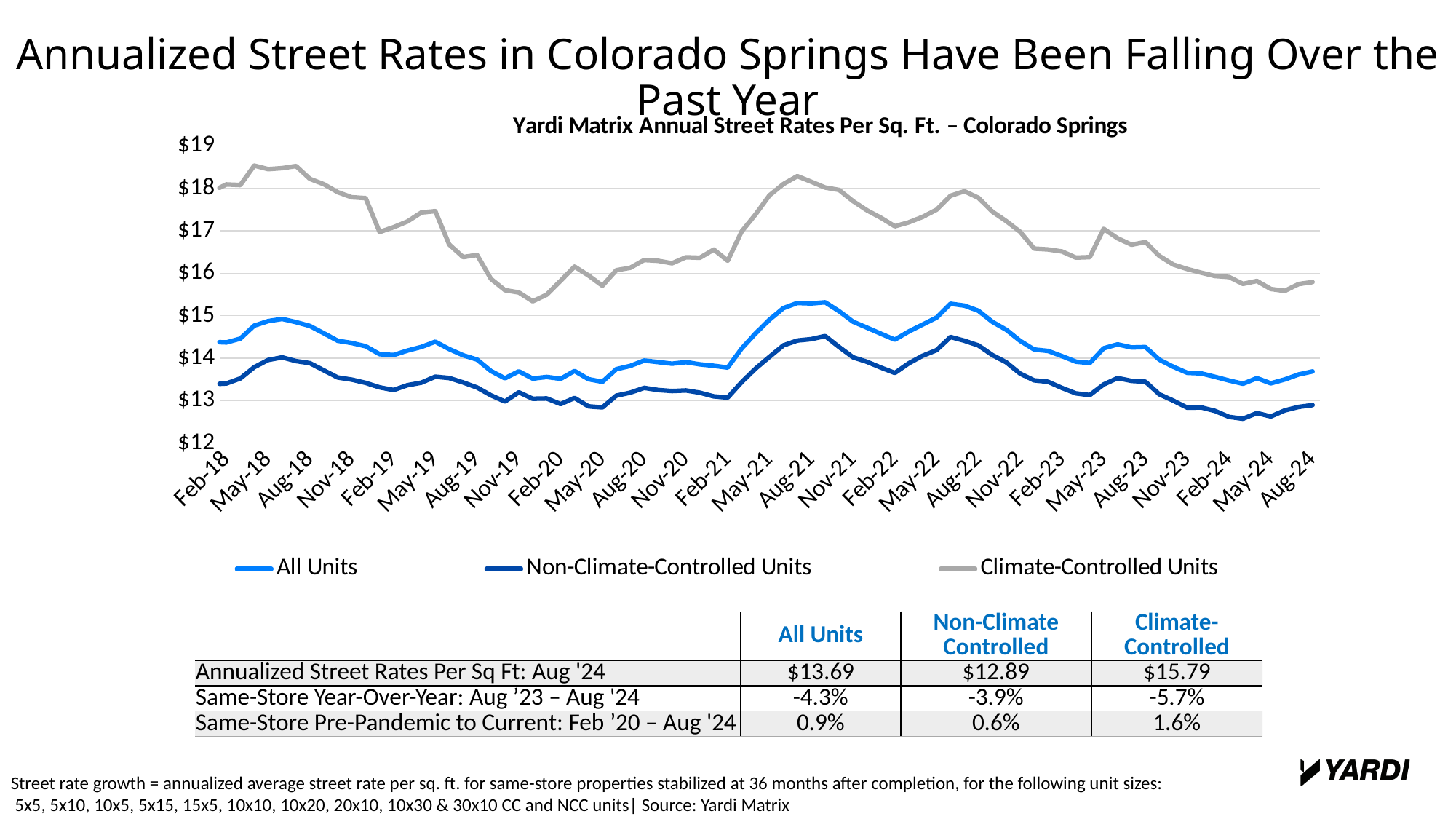
What is the annualized street rate per sq ft for Climate-Controlled units in Aug '24? $15.79 Is the value for Climate-Controlled Units in Feb-18 greater or less than $17? greater What is the difference between the Climate-Controlled and Non-Climate-Controlled rates in Aug '24? $2.90 Which series has the highest value across the whole chart? Climate-Controlled Units What kind of chart is shown on the slide? line chart Which series has the lowest value in Aug-24? Non-Climate-Controlled Units Is the value for Non-Climate-Controlled Units in Feb-24 greater or less than $13? less What is the annualized street rate per sq ft for All Units in Aug '24? $13.69 Do the Climate-Controlled Units values rise or fall from Aug-23 to Aug-24? fall Which series is plotted in grey? Climate-Controlled Units How many series does the chart legend list? 3 What is the title of the chart? Yardi Matrix Annual Street Rates Per Sq. Ft. – Colorado Springs